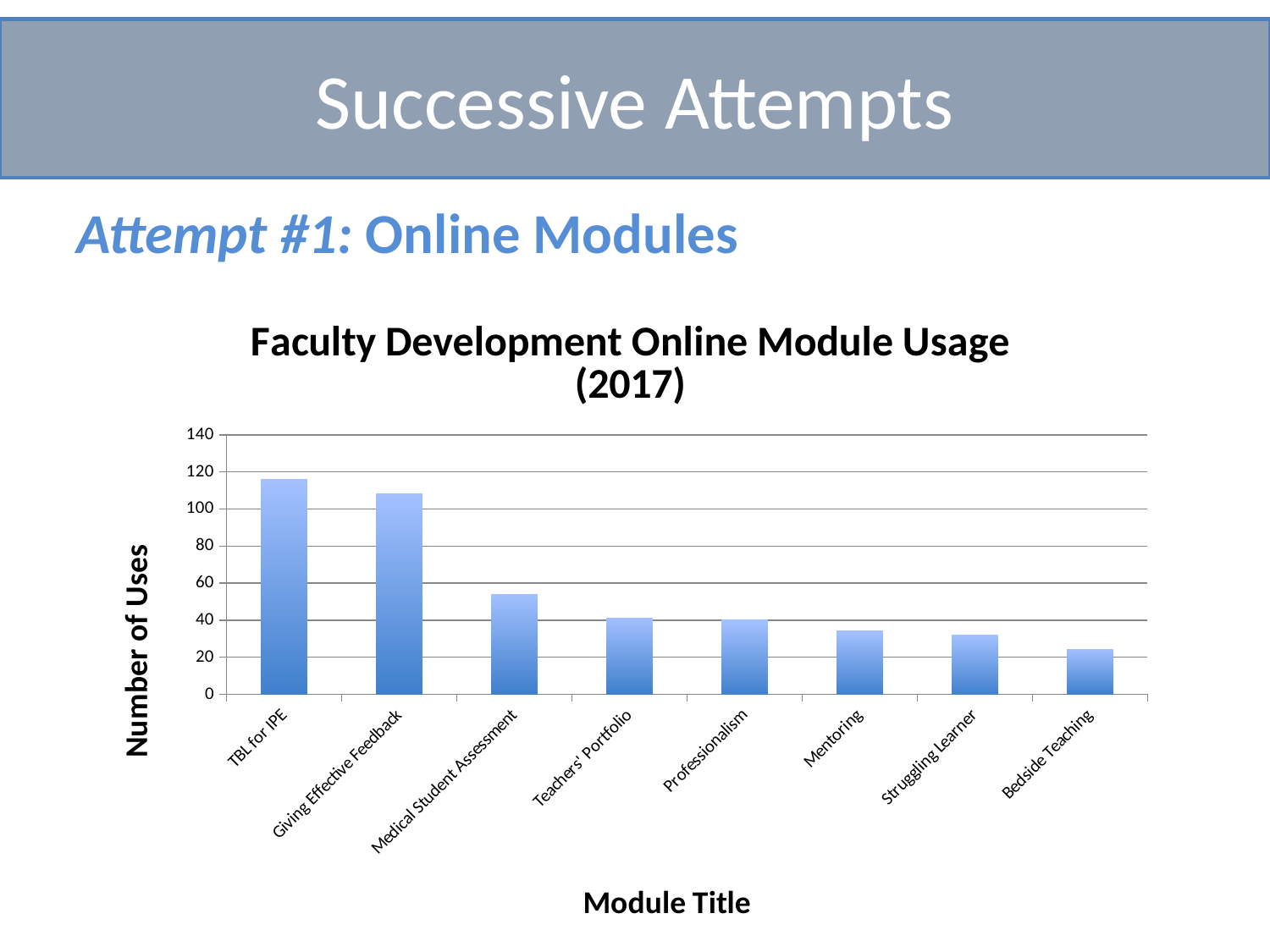
Which module has the lowest number of uses? Bedside Teaching Is the value for Giving Effective Feedback greater or less than 120? less Which has more uses, Giving Effective Feedback or Medical Student Assessment? Giving Effective Feedback What is the title of the chart? Faculty Development Online Module Usage (2017) How many modules are shown on the x axis of the chart? 8 What is the label of the y axis? Number of Uses Which module has the highest number of uses? TBL for IPE Do the values generally rise or fall moving from left to right along the x axis? fall Is the value for Bedside Teaching greater or less than 40? less What type of chart is shown on the slide? bar chart Is the value for Medical Student Assessment greater or less than 40? greater